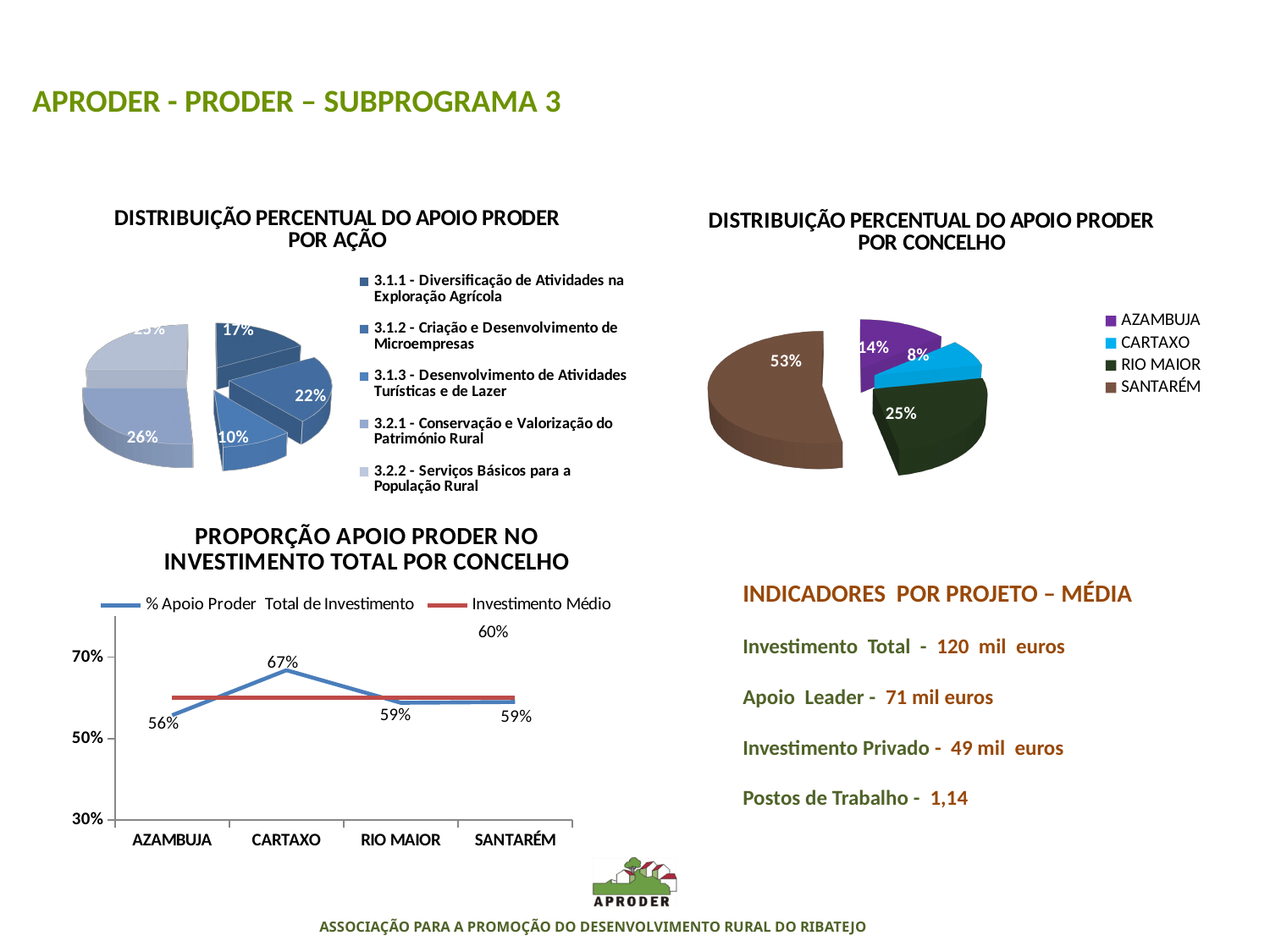
In the 'DISTRIBUIÇÃO PERCENTUAL DO APOIO PRODER POR AÇÃO' pie chart, what is the smallest percentage shown? 10% In the 'PROPORÇÃO APOIO PRODER NO INVESTIMENTO TOTAL POR CONCELHO' chart, which concelho has the lowest value? AZAMBUJA In the 'PROPORÇÃO APOIO PRODER NO INVESTIMENTO TOTAL POR CONCELHO' chart, what is the value of the Investimento Médio line? 60% In the 'PROPORÇÃO APOIO PRODER NO INVESTIMENTO TOTAL POR CONCELHO' chart, what is the value for CARTAXO? 67% In the 'DISTRIBUIÇÃO PERCENTUAL DO APOIO PRODER POR CONCELHO' pie chart, what is the difference in percentage points between SANTARÉM and RIO MAIOR? 28 percentage points How many series does the legend of the 'PROPORÇÃO APOIO PRODER NO INVESTIMENTO TOTAL POR CONCELHO' chart list? 2 In the 'DISTRIBUIÇÃO PERCENTUAL DO APOIO PRODER POR CONCELHO' pie chart, which concelho has the smallest share? CARTAXO In the 'DISTRIBUIÇÃO PERCENTUAL DO APOIO PRODER POR CONCELHO' pie chart, which concelho has the largest share? SANTARÉM In the 'DISTRIBUIÇÃO PERCENTUAL DO APOIO PRODER POR CONCELHO' pie chart, what share does SANTARÉM have? 53% How many actions are listed in the legend of the 'DISTRIBUIÇÃO PERCENTUAL DO APOIO PRODER POR AÇÃO' chart? 5 What kind of chart is 'PROPORÇÃO APOIO PRODER NO INVESTIMENTO TOTAL POR CONCELHO'? Line chart How many concelhos are listed in the legend of the 'DISTRIBUIÇÃO PERCENTUAL DO APOIO PRODER POR CONCELHO' chart? 4